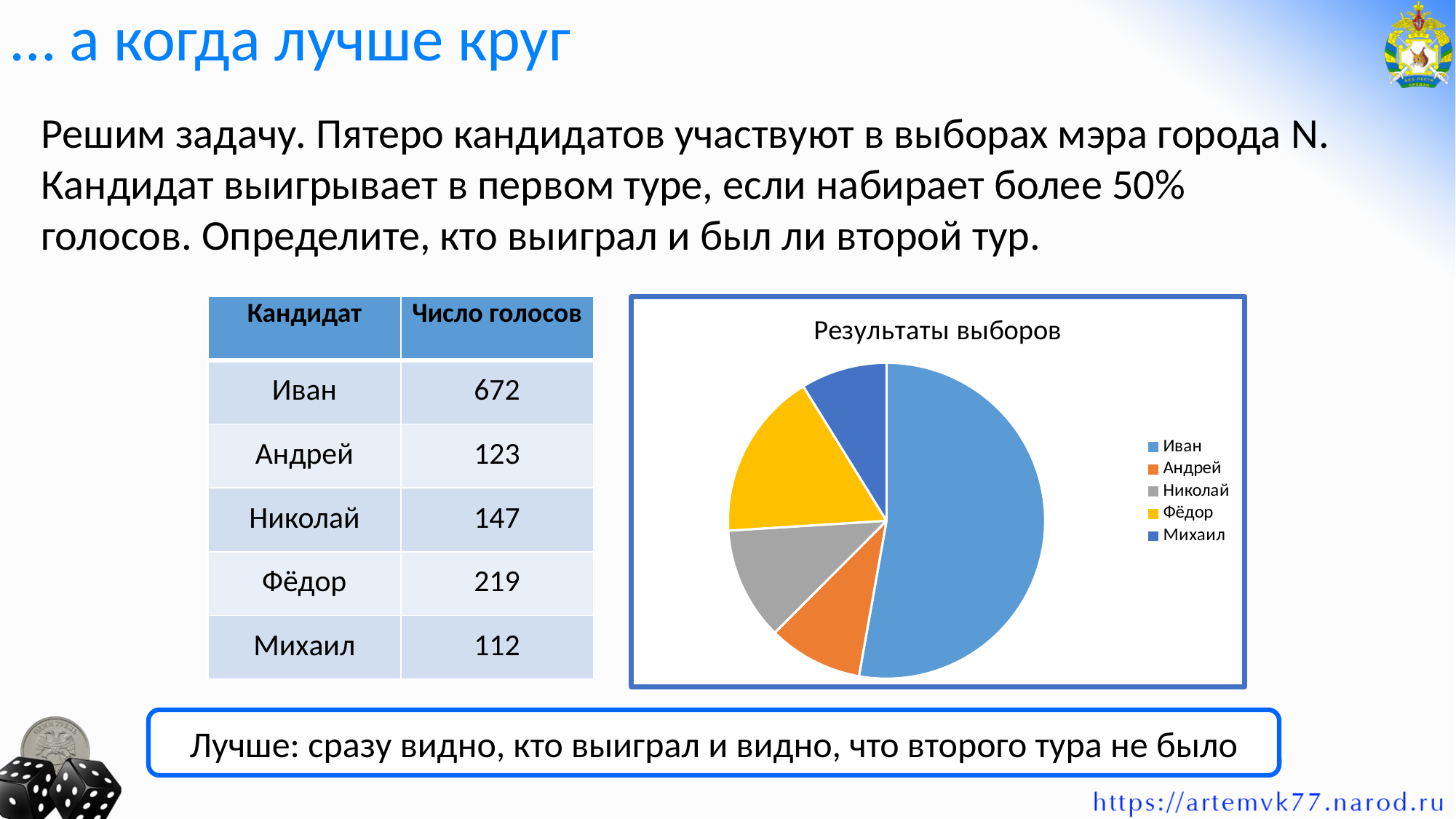
Which candidate has the smallest slice in the pie chart? Михаил What is the title of the pie chart? Результаты выборов What kind of chart is shown on the slide? Pie chart How many votes does Николай have according to the slide? 147 How many votes does Фёдор have according to the slide? 219 Which candidate has the largest slice in the pie chart? Иван What colour is the slice for Фёдор in the pie chart? Yellow By how many votes does Иван exceed Фёдор? 453 How many slices does the pie chart have? 5 Who has more votes, Фёдор or Николай? Фёдор Does Иван's slice take up more or less than half of the pie? more How many entries does the legend of the pie chart list? 5